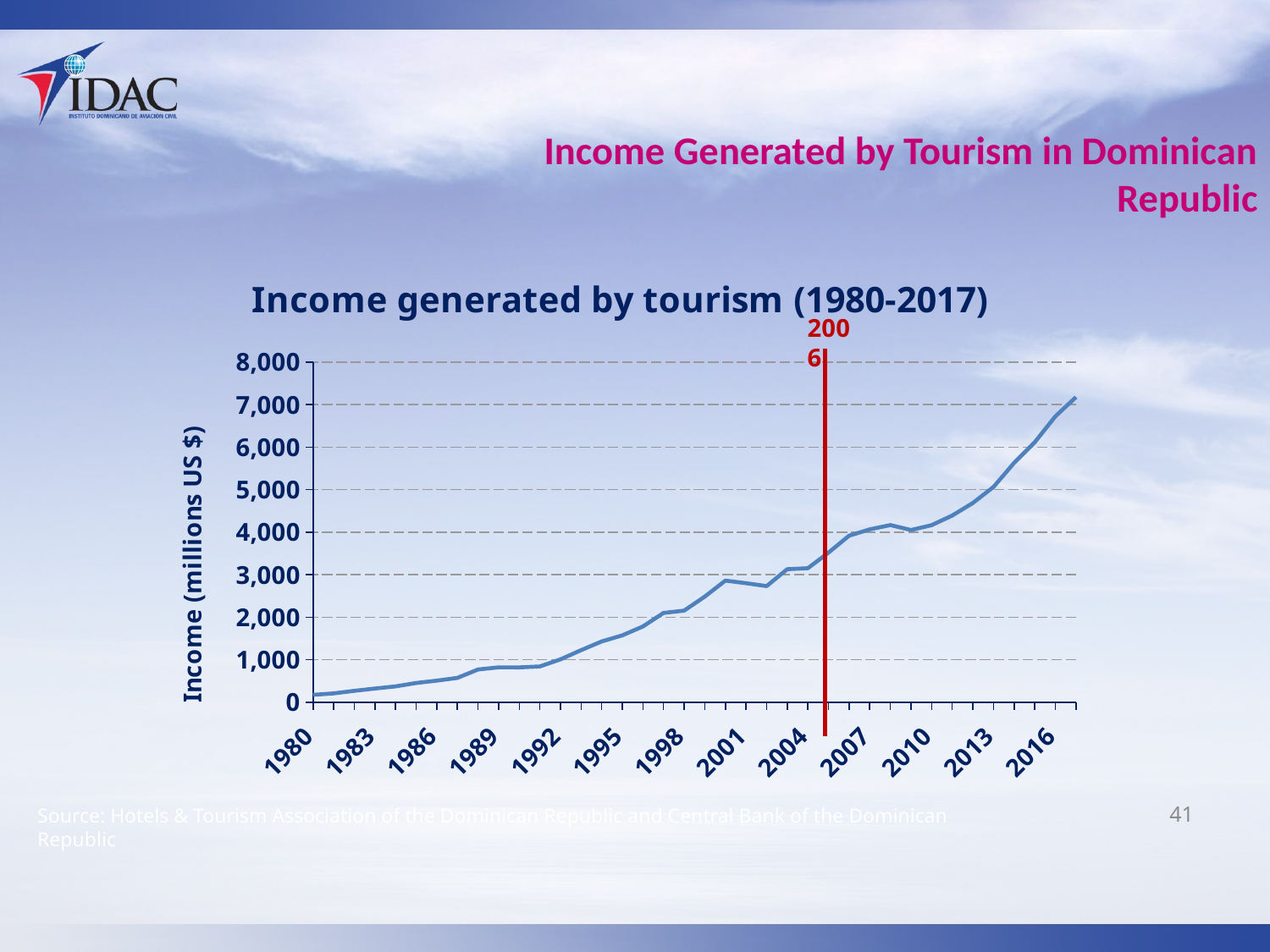
Which year has the highest tourism income? 2017 Is the value for 2006 greater or less than 3,000? greater Is the value for 2017 greater or less than 6,000? greater What kind of chart is shown on the slide? line chart What is the label of the vertical axis? Income (millions US $) Which year has the lowest tourism income? 1980 Overall, does tourism income rise or fall from 1980 to 2017? rise Is the value for 2013 greater or less than 4,000? greater What is the title of the chart? Income generated by tourism (1980-2017) Which year has the larger tourism income, 1998 or 2010? 2010